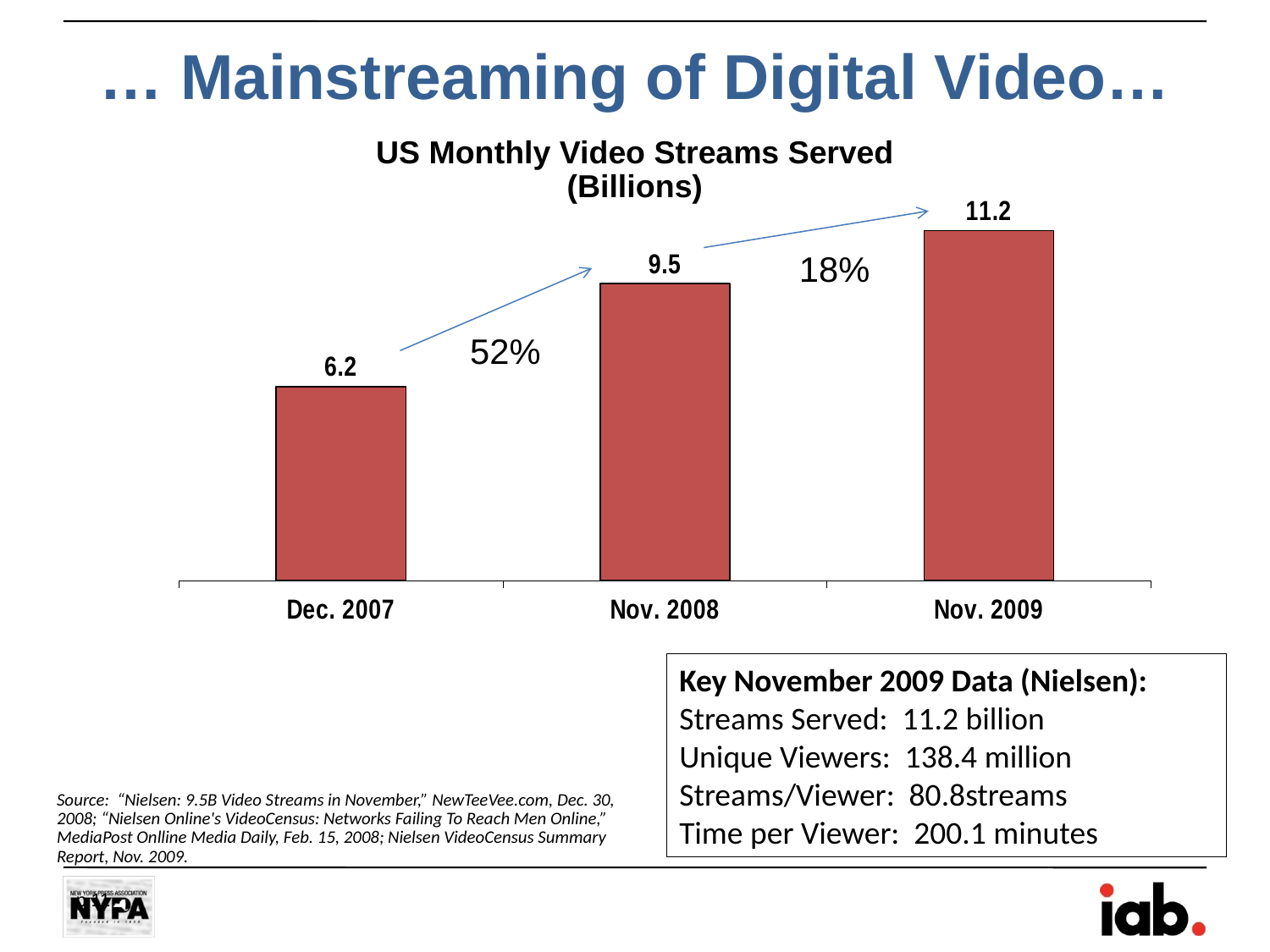
What is the difference between the Nov. 2008 and Dec. 2007 values in the US Monthly Video Streams Served chart? 3.3 Do the values in the US Monthly Video Streams Served chart rise or fall from Dec. 2007 to Nov. 2009? Rise What is the value for Dec. 2007 in the US Monthly Video Streams Served chart? 6.2 How many periods are shown in the US Monthly Video Streams Served chart? 3 What percentage growth is annotated between Dec. 2007 and Nov. 2008 in the US Monthly Video Streams Served chart? 52% Which period has the lowest value in the US Monthly Video Streams Served chart? Dec. 2007 What kind of chart is the US Monthly Video Streams Served chart? Bar chart What is the value for Nov. 2009 in the US Monthly Video Streams Served chart? 11.2 What is the difference between the Nov. 2009 and Dec. 2007 values in the US Monthly Video Streams Served chart? 5.0 Which is larger in the US Monthly Video Streams Served chart, Nov. 2008 or Nov. 2009? Nov. 2009 What is the value for Nov. 2008 in the US Monthly Video Streams Served chart? 9.5 Which period has the highest value in the US Monthly Video Streams Served chart? Nov. 2009